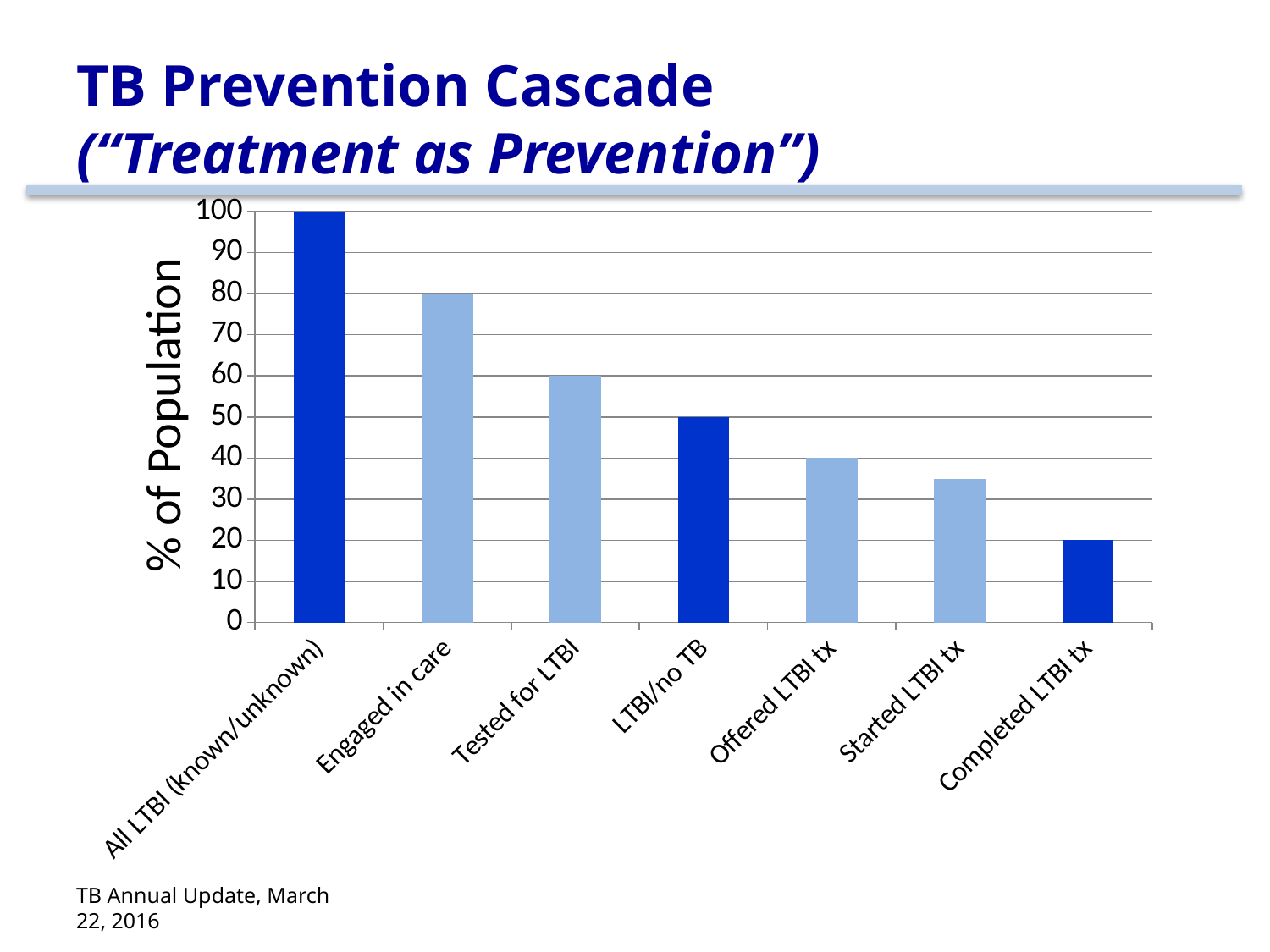
What is the value for LTBI/no TB? 50 Do the values rise or fall from left to right along the x axis? fall What kind of chart is shown on the slide? bar chart Is the value for Started LTBI tx greater or less than 40? less Which category has the lowest value? Completed LTBI tx What is the value for Tested for LTBI? 60 What is the difference between the values for Engaged in care and Offered LTBI tx? 40 How many categories are shown on the x axis of the chart? 7 What is the value for Engaged in care? 80 What is the value for Completed LTBI tx? 20 What is the value for All LTBI (known/unknown)? 100 Which category has the highest value? All LTBI (known/unknown)